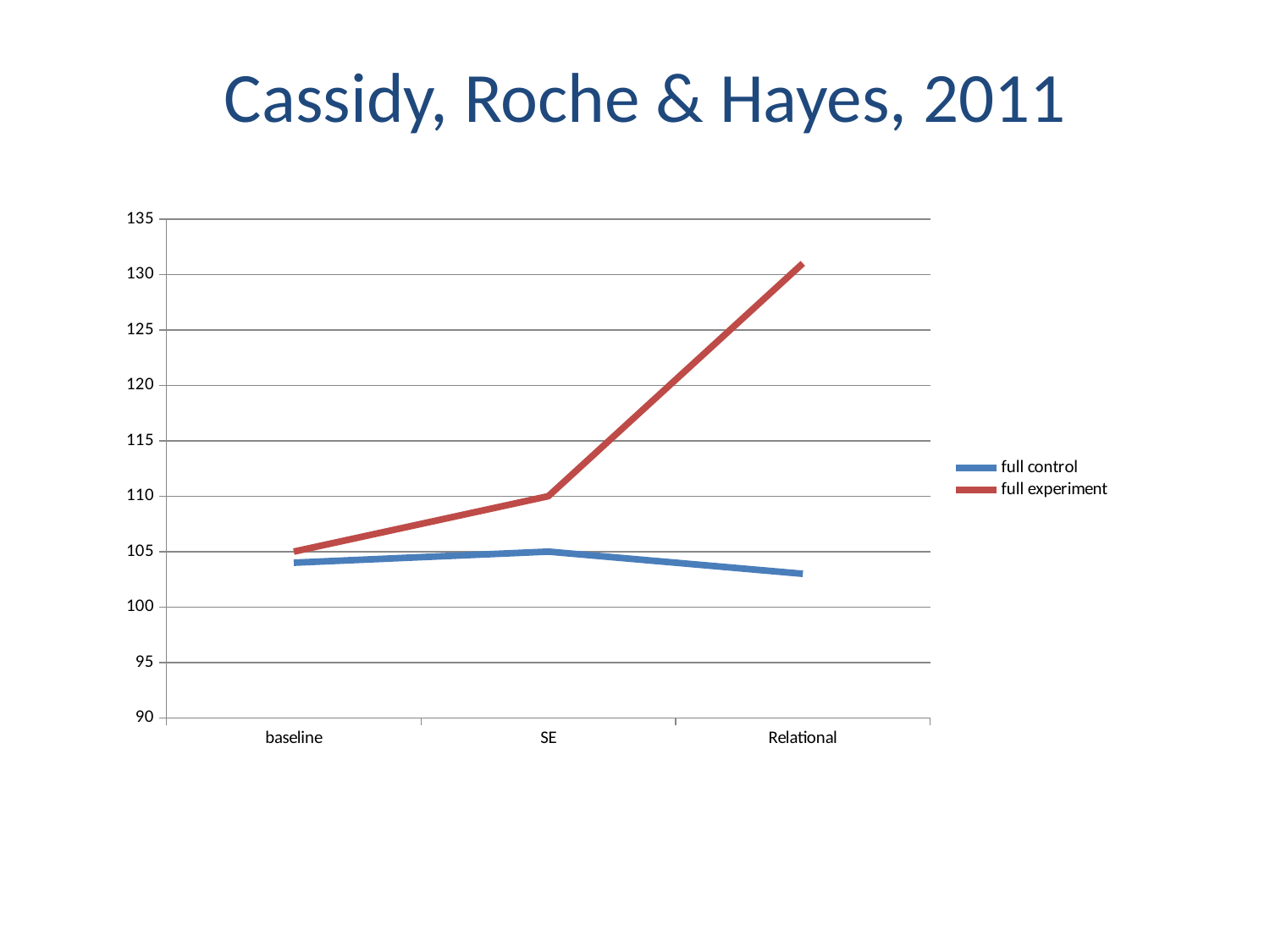
Is the value for full control at baseline greater or less than 100? greater Does the full experiment series rise or fall from baseline to Relational? rise How many series does the legend list? 2 What kind of chart is shown on the slide? line chart Is the value for full experiment at Relational greater or less than 125? greater Is the value for full control at Relational greater or less than 105? less At which category does the full experiment series reach its highest value? Relational What is the value for full experiment at SE? 110 Which colour is used for the full control series? blue What is the value for full experiment at baseline? 105 At Relational, which series has the larger value, full control or full experiment? full experiment How many categories are shown on the x axis? 3